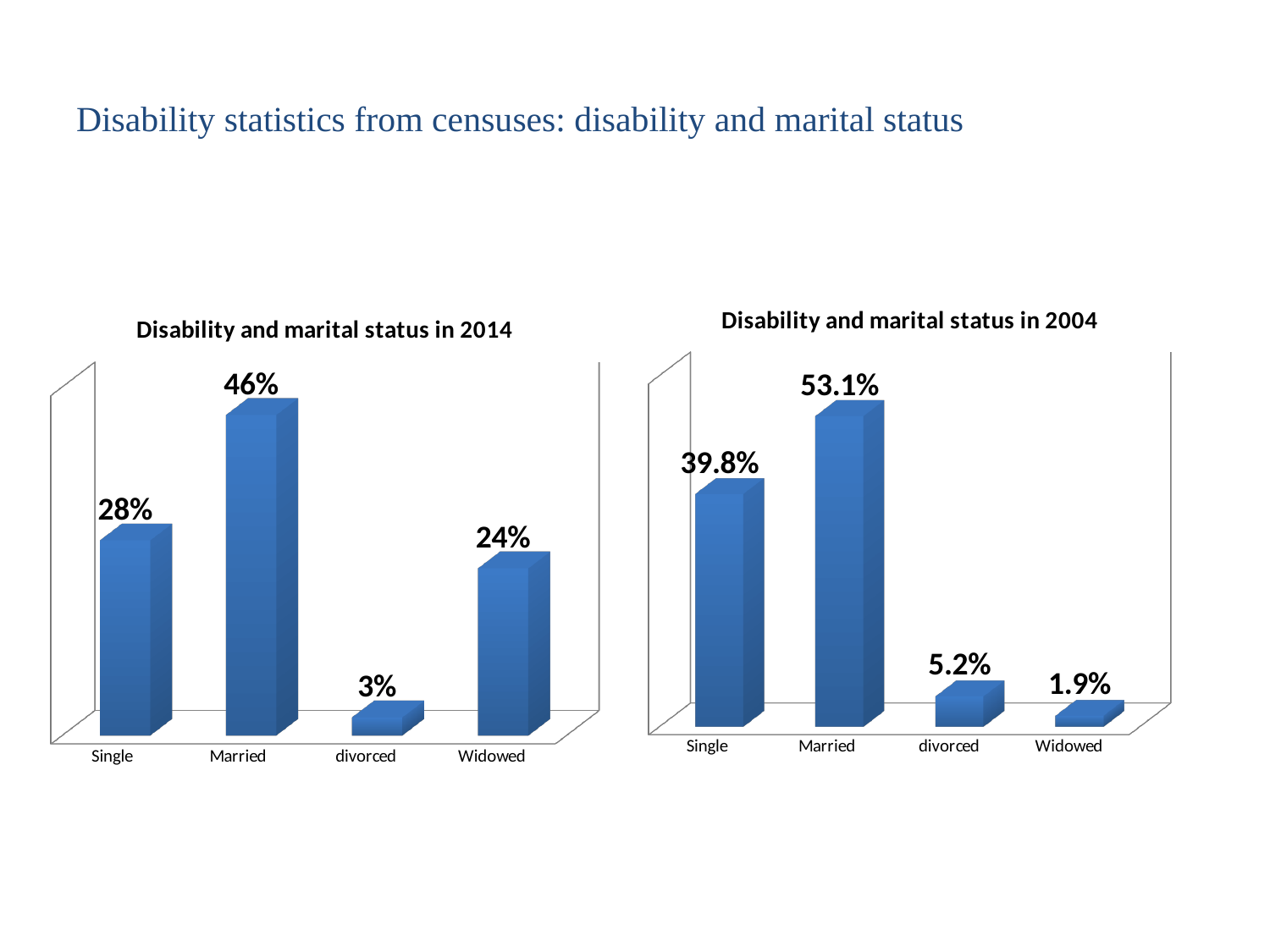
In the 'Disability and marital status in 2014' chart, what is the value for Married? 46% In the 'Disability and marital status in 2004' chart, what is the value for Single? 39.8% What is the title of the chart on the left side of the slide? Disability and marital status in 2014 In the 'Disability and marital status in 2004' chart, which is larger, the value for divorced or the value for Widowed? divorced In the 'Disability and marital status in 2004' chart, what is the difference between the values for Married and Single? 13.3% In the 'Disability and marital status in 2004' chart, which category has the lowest value? Widowed How many categories are shown in the 'Disability and marital status in 2014' chart? 4 In the 'Disability and marital status in 2014' chart, what is the difference between the values for Single and Widowed? 4% In the 'Disability and marital status in 2014' chart, which is larger, the value for Single or the value for Widowed? Single What kind of chart is the 'Disability and marital status in 2004' chart? Bar chart In the 'Disability and marital status in 2014' chart, which category has the highest value? Married In the 'Disability and marital status in 2004' chart, what is the value for Widowed? 1.9%